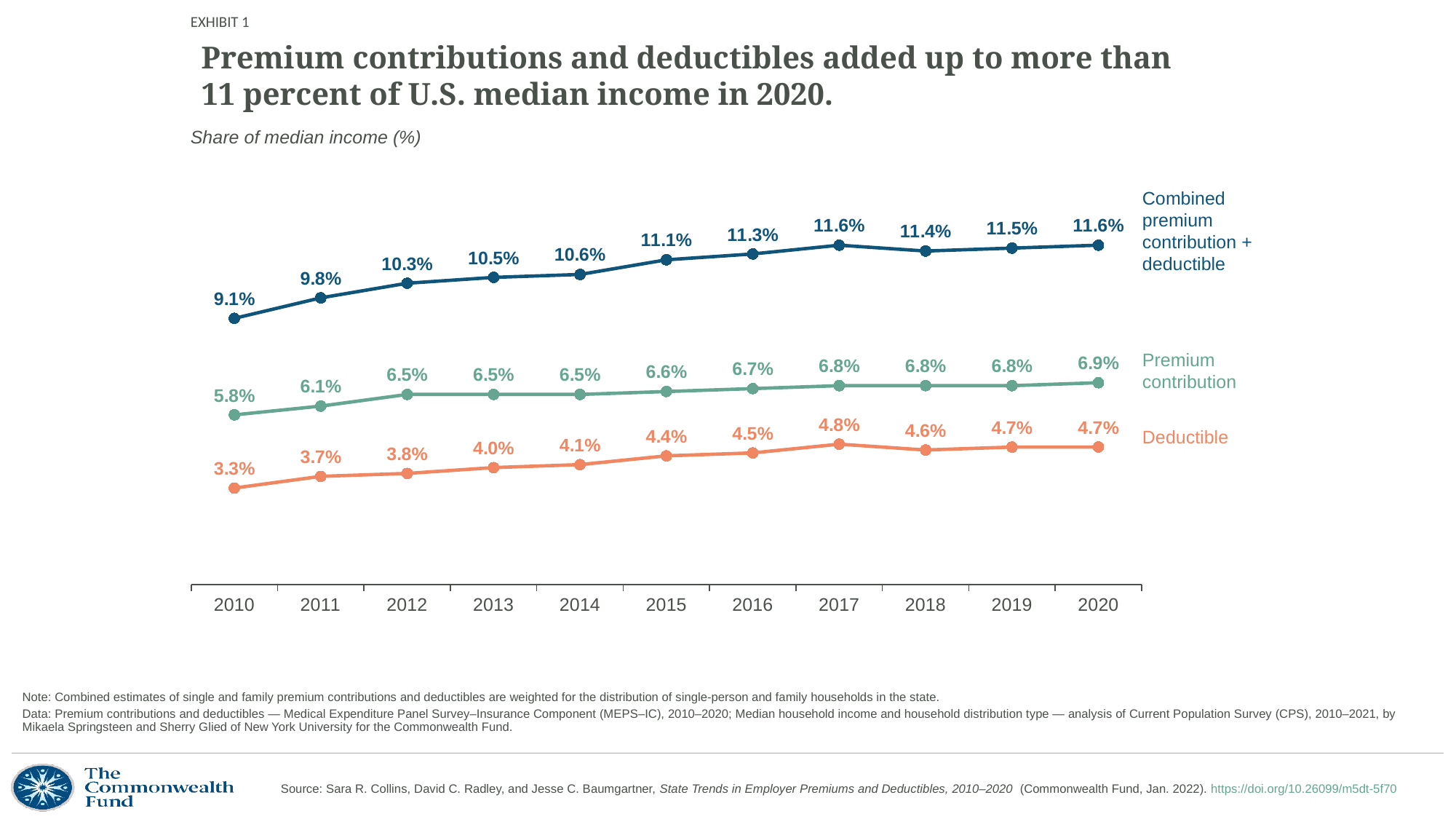
What kind of chart is shown on the slide? Line chart What was the premium contribution share of median income in 2015? 6.6% Which was larger in 2014: the premium contribution share or the deductible share? Premium contribution What is the difference between the combined premium contribution + deductible share in 2020 and in 2010? 2.5 percentage points In which year was the deductible share of median income highest? 2017 How many series are plotted on the chart? 3 How many years are shown on the x axis? 11 What was the combined premium contribution + deductible share of median income in 2020? 11.6% What is the difference between the premium contribution share and the deductible share in 2020? 2.2 percentage points In which year was the combined premium contribution + deductible share lowest? 2010 What was the deductible share of median income in 2010? 3.3% Does the deductible share of median income generally rise or fall from 2010 to 2020? Rise